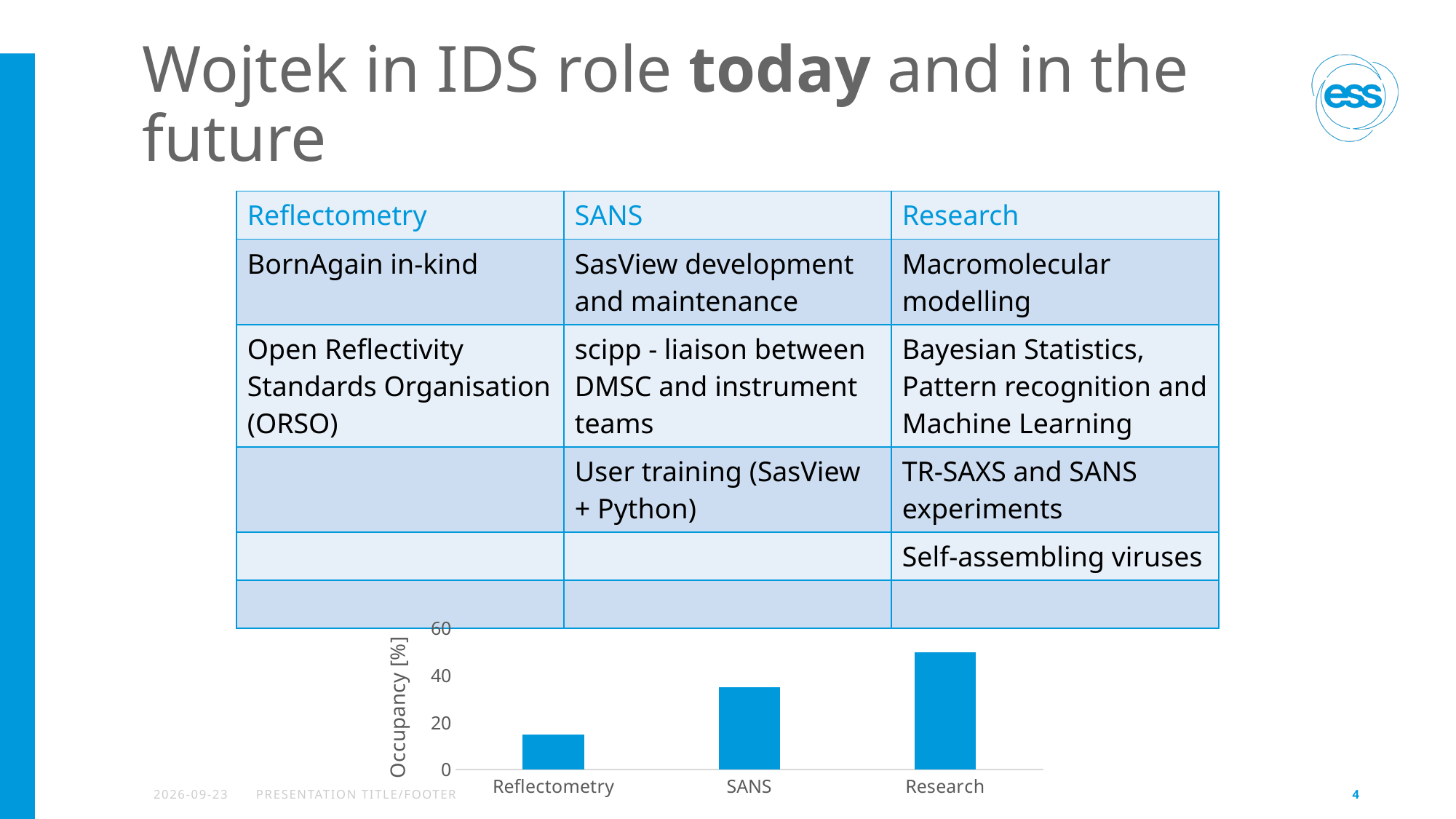
Is the value for SANS greater or less than 40? less Is the value for Research greater or less than 40? greater Is the value for Reflectometry greater or less than 20? less Which category has the highest occupancy in the bar chart? Research Do the bar values rise or fall from Reflectometry to Research along the x axis? rise What kind of chart is shown at the bottom of the slide? bar chart Which is larger in the bar chart, the value for Research or the value for SANS? Research What is the label of the vertical axis in the bar chart? Occupancy [%] Which is larger in the bar chart, the value for SANS or the value for Reflectometry? SANS Which category has the lowest occupancy in the bar chart? Reflectometry How many categories are plotted in the bar chart? 3